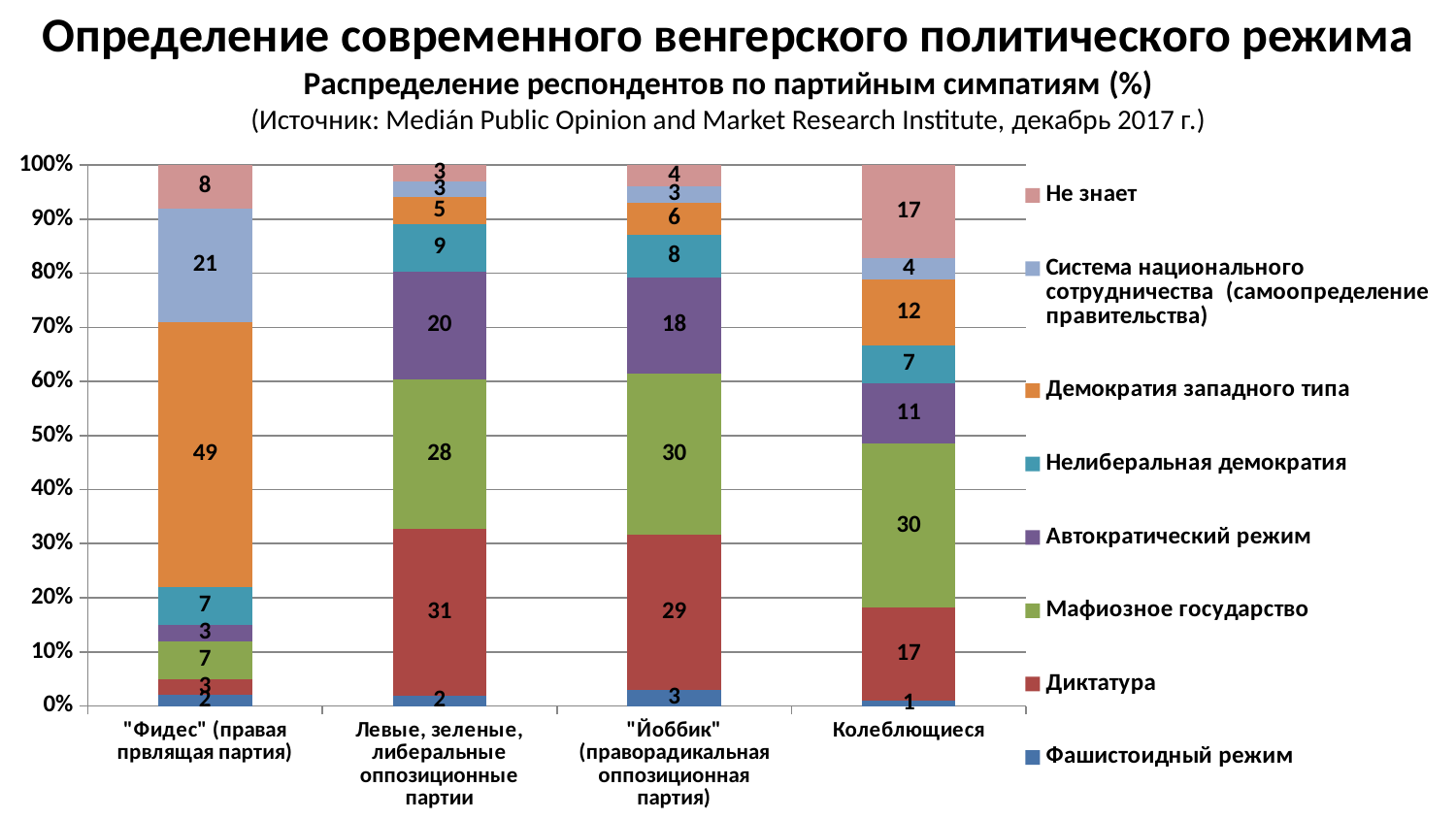
Which category has the lowest value for "Фашистоидный режим"? Колеблющиеся What is the value for "Демократия западного типа" among "Фидес" supporters? 49 Which is larger: the "Автократический режим" value for "Левые, зеленые, либеральные оппозиционные партии" or for "Йоббик"? Левые, зеленые, либеральные оппозиционные партии Which source is cited in the chart subtitle? Medián Public Opinion and Market Research Institute, декабрь 2017 г. What is the value for "Диктатура" among "Левые, зеленые, либеральные оппозиционные партии" supporters? 31 Which category has the highest value for "Система национального сотрудничества"? "Фидес" (правая првлящая партия) What is the value for "Мафиозное государство" among "Йоббик" supporters? 30 How many party-sympathy categories are shown on the x axis? 4 What is the difference between the "Демократия западного типа" values for "Фидес" and "Колеблющиеся"? 37 What kind of chart is shown on the slide? stacked bar chart How many series does the legend list? 8 What is the value for "Не знает" among "Колеблющиеся"? 17